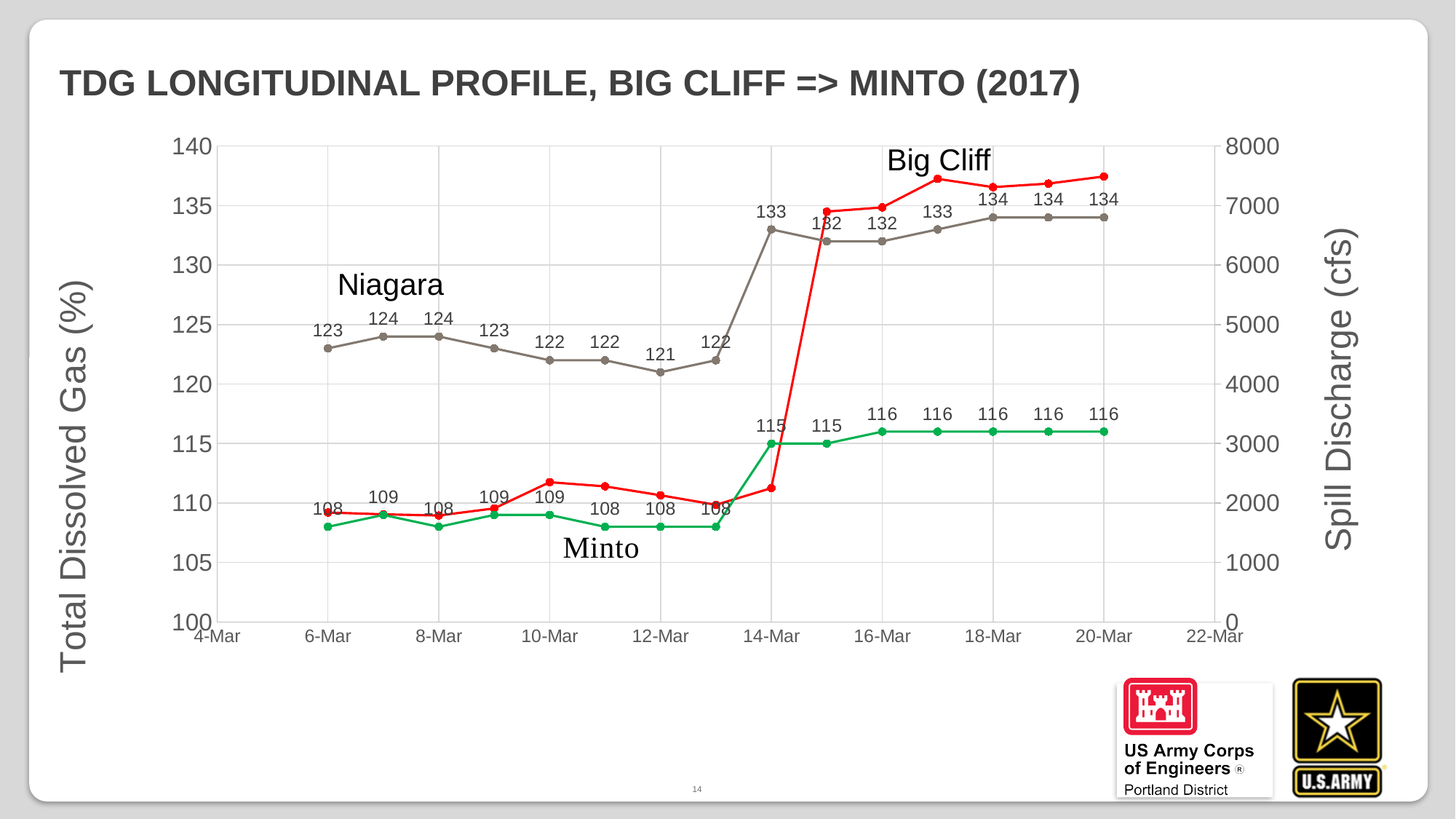
How many data points are plotted for the Niagara series? 15 What is the Minto value on 20-Mar? 116 What is the difference between the Niagara and Minto values on 14-Mar? 18 Is the Niagara value higher on 6-Mar or on 8-Mar? 8-Mar What kind of chart is shown on the slide? line chart What is the Niagara value on 12-Mar? 121 Does the Minto series rise or fall between 13-Mar and 14-Mar? rise How many data series are plotted on the chart? 3 What is the title of the left vertical axis? Total Dissolved Gas (%) What is the Niagara value on 14-Mar? 133 On which date does the Niagara series reach its lowest value? 12-Mar What is the highest value shown for the Minto series? 116